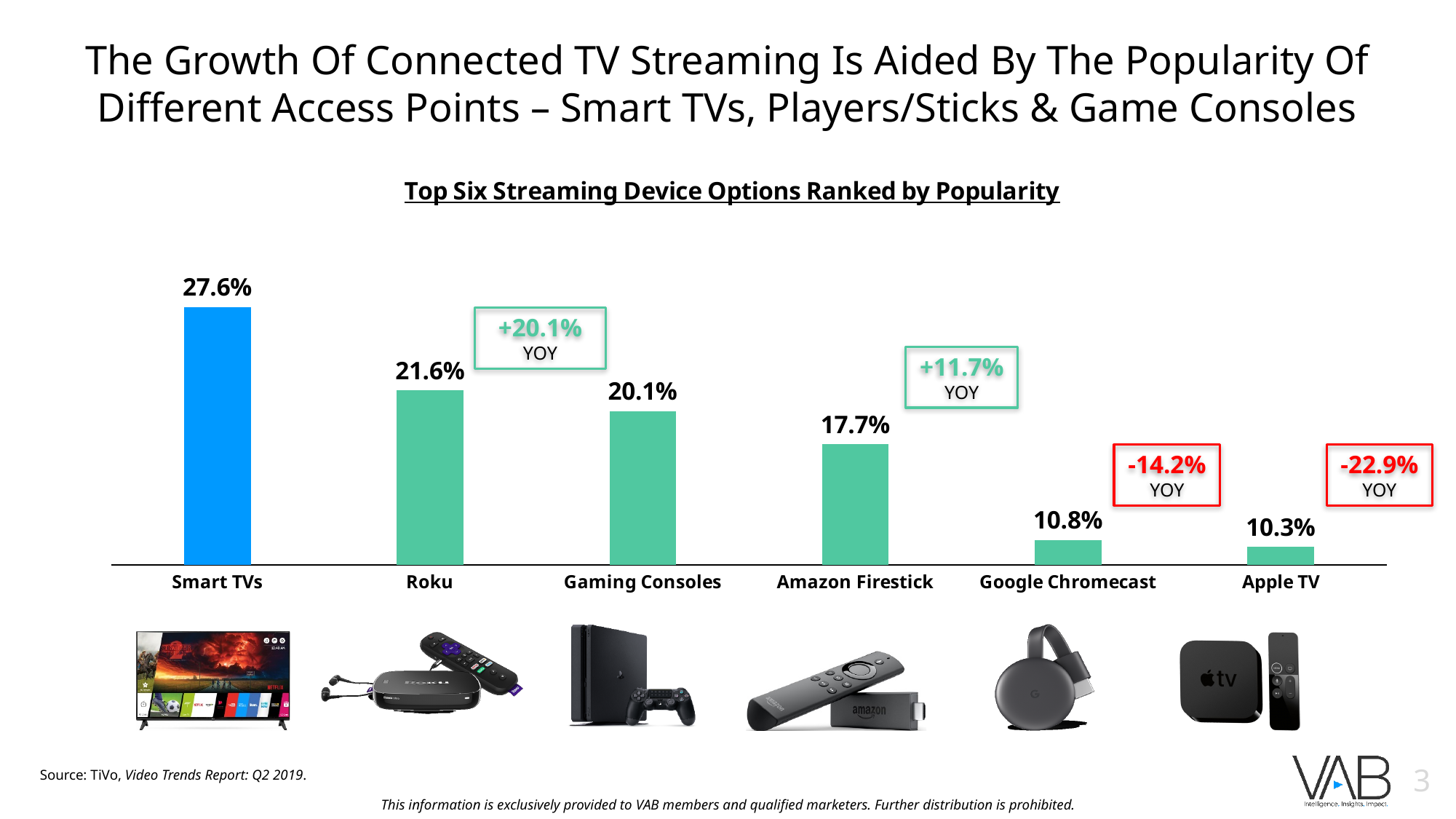
What year-over-year change is shown for Apple TV? -22.9% What is the difference between the values for Smart TVs and Apple TV? 17.3% Which is larger, the value for Roku or the value for Amazon Firestick? Roku What is the difference between the values for Roku and Gaming Consoles? 1.5% What is the value for Amazon Firestick? 17.7% Which streaming device option has the lowest value? Apple TV What kind of chart is shown on the slide? Bar chart How many streaming device options are shown in the chart? 6 Do the values rise or fall from left to right across the categories? Fall What is the value for Smart TVs? 27.6% What is the value for Google Chromecast? 10.8% Which streaming device option has the highest value? Smart TVs